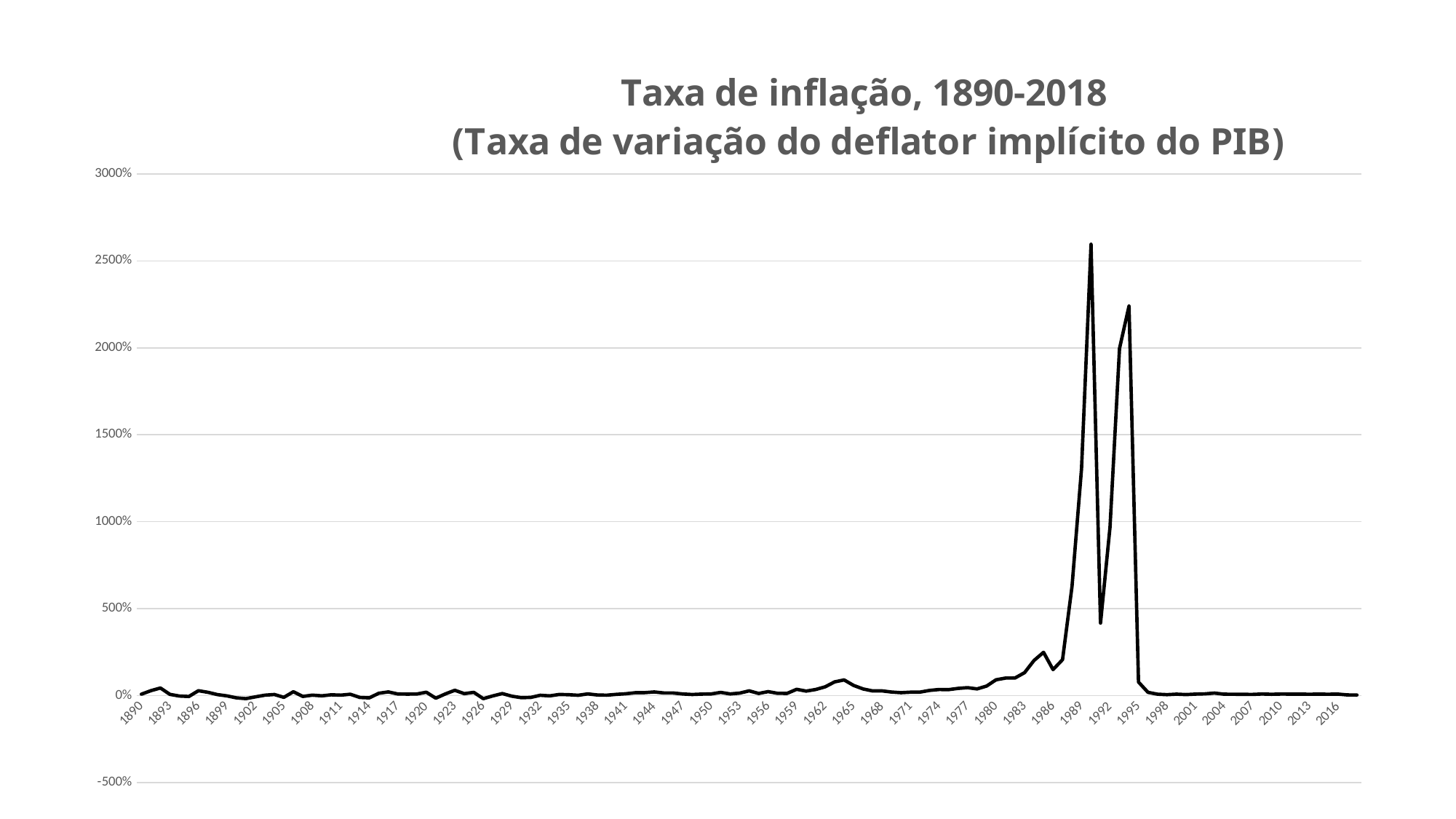
Is the highest peak of the line greater or less than 2000%? greater What is the highest value shown on the vertical axis? 3000% What kind of chart is shown on the slide? line chart Is the value for 1965 greater or less than 500%? less Is the value for 1890 greater or less than 500%? less Does the highest peak of the line occur before or after 1986? after Do the values rise or fall between 1995 and 1998? fall Do the values rise or fall between 1986 and 1989? rise What is the title of the chart? Taxa de inflação, 1890-2018 (Taxa de variação do deflator implícito do PIB)